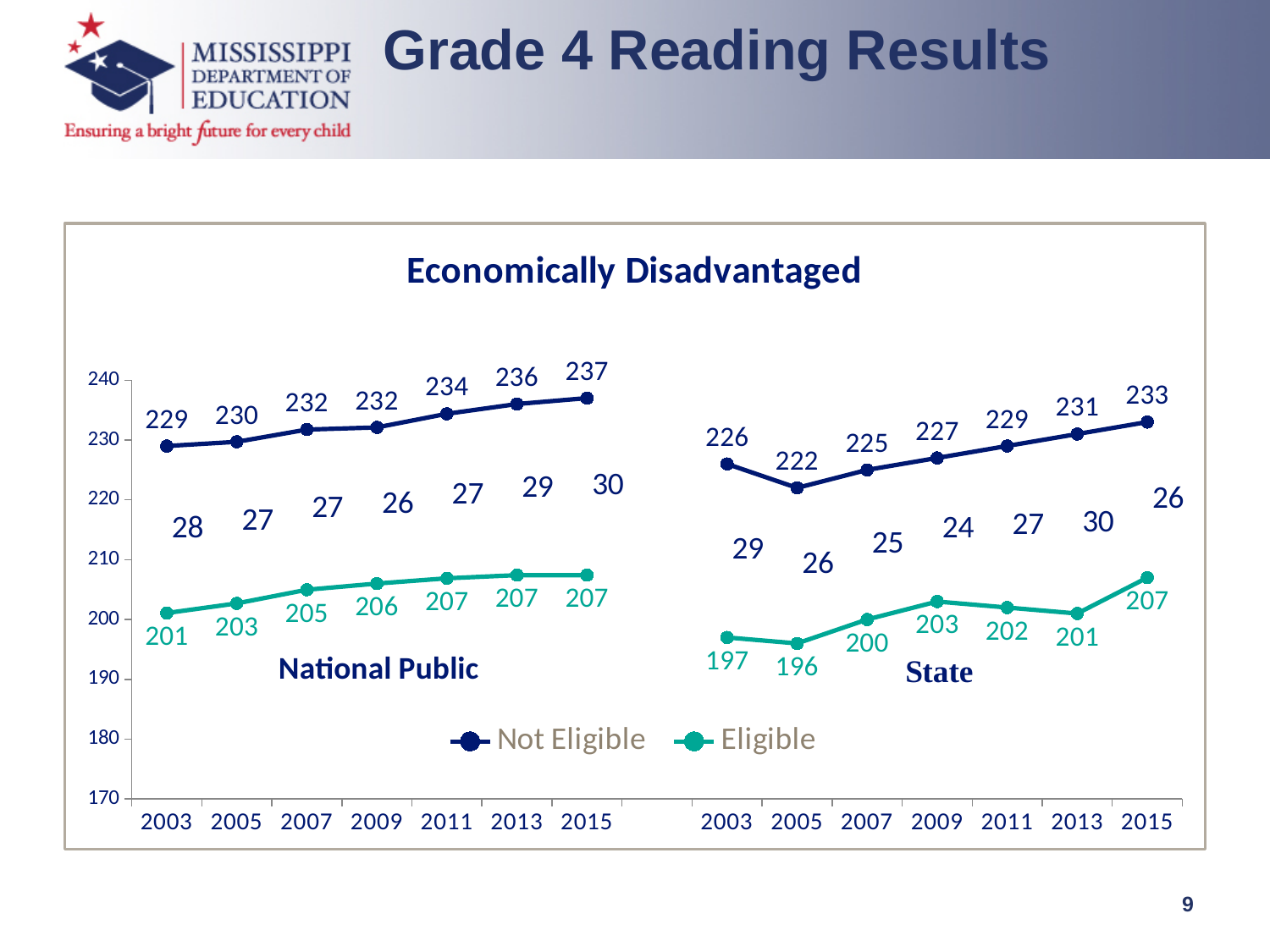
In the National Public panel, does the Not Eligible line rise or fall from 2003 to 2015? rise Which is larger: the 2013 Eligible value for National Public or the 2013 Eligible value for State? National Public In the State panel, what is the Not Eligible value for 2009? 227 In the State panel, which year has the lowest Not Eligible value? 2005 How many years are plotted on the x axis of the State panel? 7 In the State panel, what is the difference between the Not Eligible and Eligible values in 2015? 26 In the National Public panel, which year has the highest Eligible value? 2011, 2013 and 2015 (all 207) What type of chart is shown on the slide? line chart In the National Public panel, what is the difference between the Not Eligible values for 2015 and 2003? 8 In the State panel, what is the Eligible value for 2005? 196 How many series does the legend list? 2 In the National Public panel, what is the Not Eligible value for 2015? 237